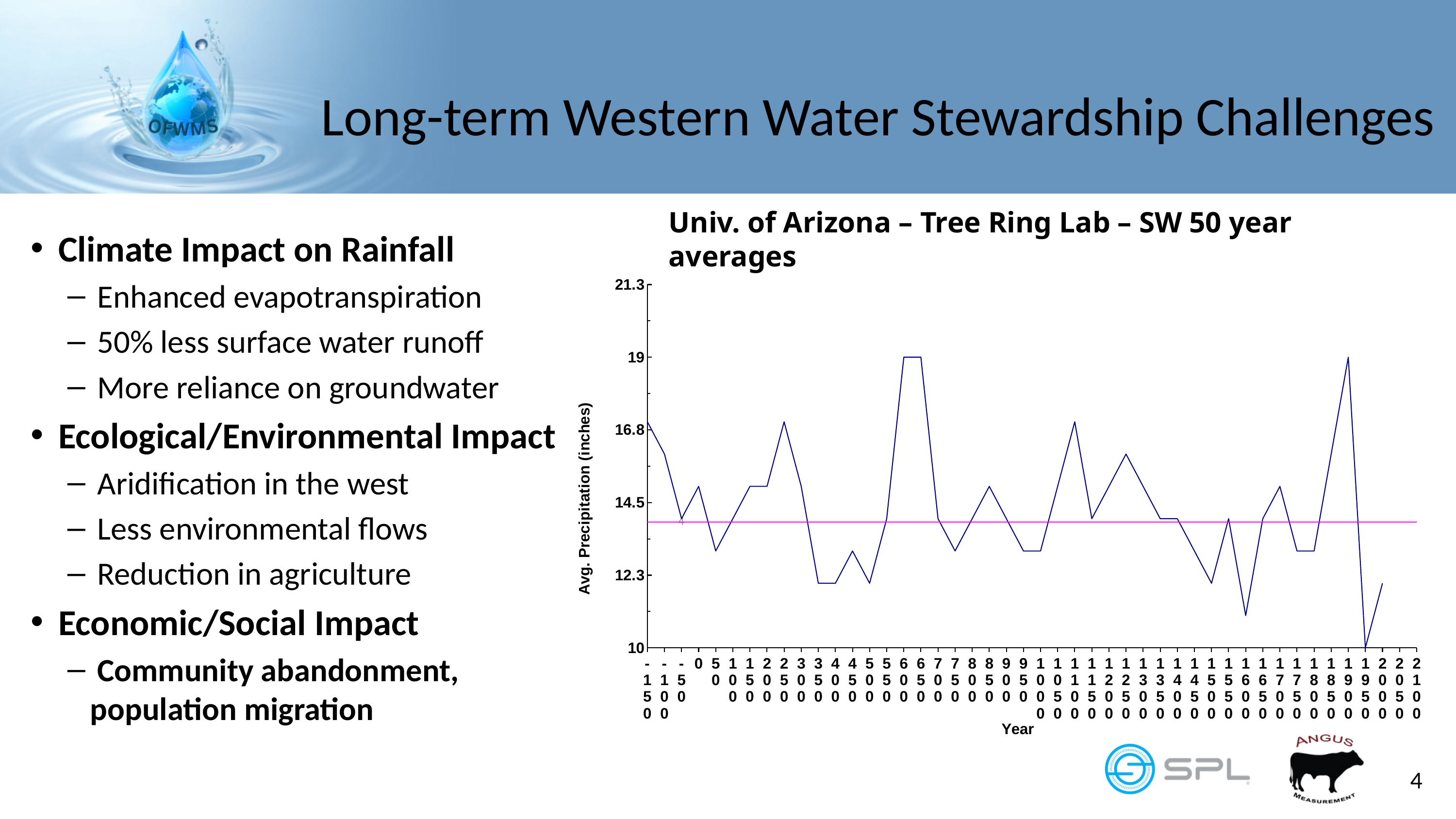
What is the label of the vertical axis of the chart? Avg. Precipitation (inches) Is the value for the year 1650 greater or less than 12.3? greater Does the average precipitation rise or fall between the years 1900 and 1950? fall Which year has the larger average precipitation, 600 or 1950? 600 Is the value for the year 1200 greater or less than 14.5? greater Is the value for the year 1000 greater or less than 14.5? less What is the title of the chart? Univ. of Arizona – Tree Ring Lab – SW 50 year averages What is the average precipitation value plotted for the year 600? 19 Which year has the lowest average precipitation in the chart? 1950 How many year labels are shown along the x axis of the chart? 46 What kind of chart is shown on the slide? line chart What is the average precipitation value plotted for the year 1950? 10